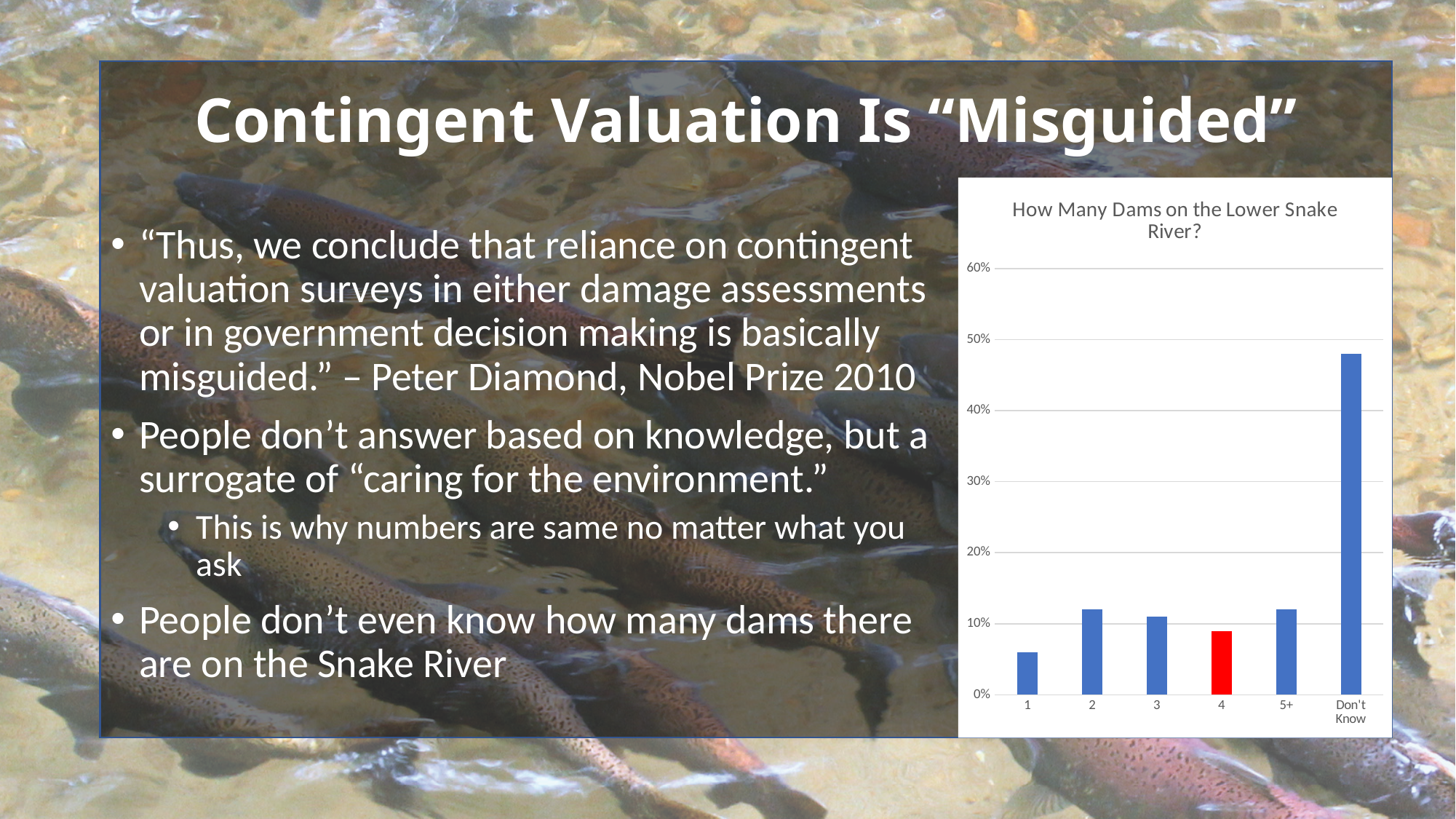
How many categories are shown on the x axis of the chart? 6 Is the value for category 2 greater or less than 10%? greater What is the title of the chart on the slide? How Many Dams on the Lower Snake River? Is the value for category 4 greater or less than 10%? less Is the value for Don't Know greater or less than 40%? greater Which category has the highest value in the chart? Don't Know What kind of chart is shown on the slide? bar chart Which bar in the chart is coloured red? 4 Which is larger, the value for Don't Know or the value for 5+? Don't Know Which category has the lowest value in the chart? 1